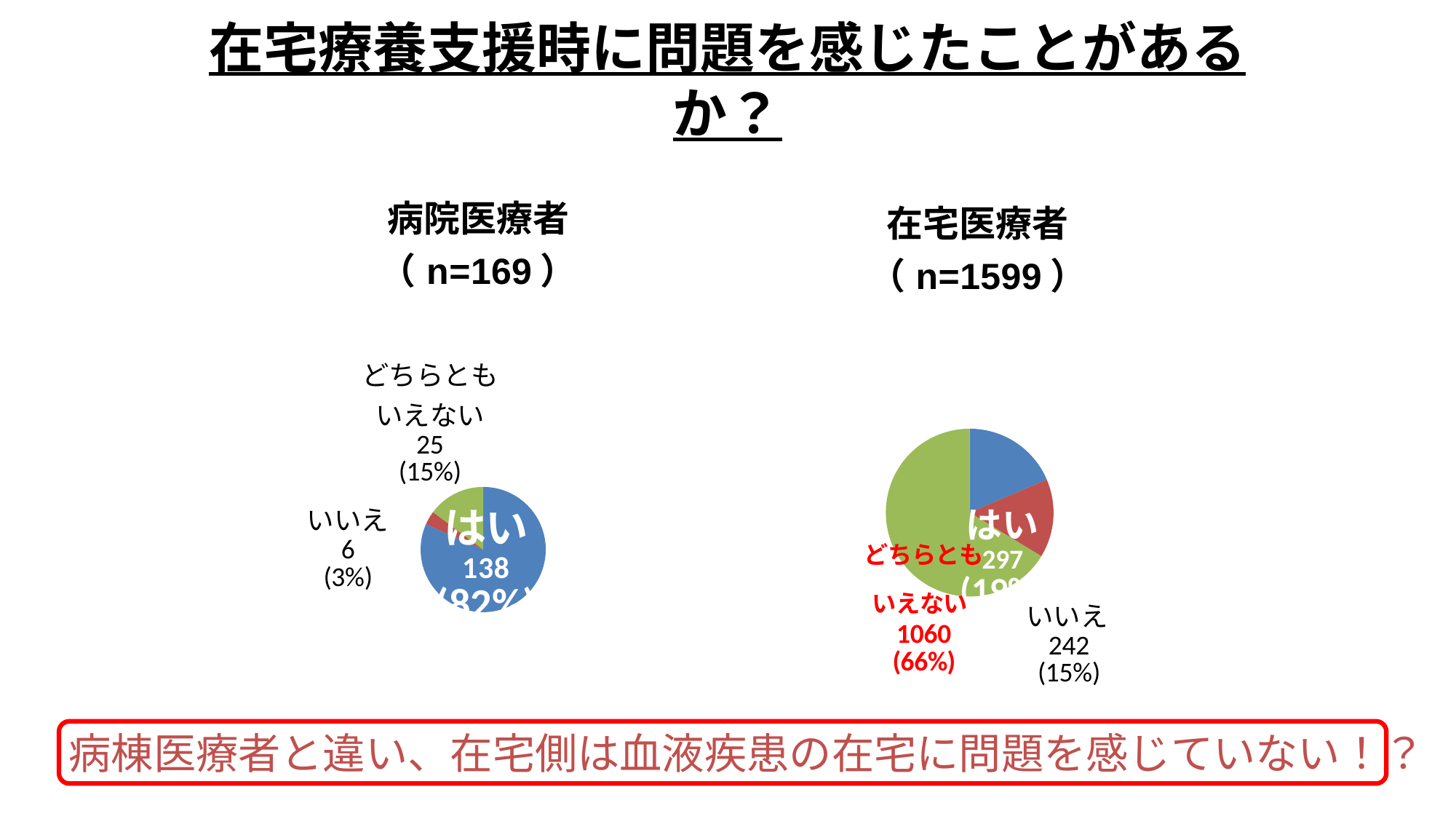
In the 病院医療者 (n=169) chart, what is the value for いいえ? 6 (3%) What kind of charts are shown on the slide? Pie charts In the 在宅医療者 (n=1599) chart, how many respondents answered はい? 297 In the 病院医療者 (n=169) chart, which category is the largest? はい In the 在宅医療者 (n=1599) chart, which category is the largest? どちらともいえない In the 病院医療者 (n=169) chart, which category is the smallest? いいえ In the 在宅医療者 (n=1599) chart, what is the value for どちらともいえない? 1060 (66%) In the 在宅医療者 (n=1599) chart, what is the difference between どちらともいえない and いいえ? 818 How many categories does each pie chart have? 3 In the 在宅医療者 (n=1599) chart, what is the value for いいえ? 242 (15%) In the 病院医療者 (n=169) chart, what is the value for はい? 138 (82%) In the 病院医療者 (n=169) chart, what is the value for どちらともいえない? 25 (15%)